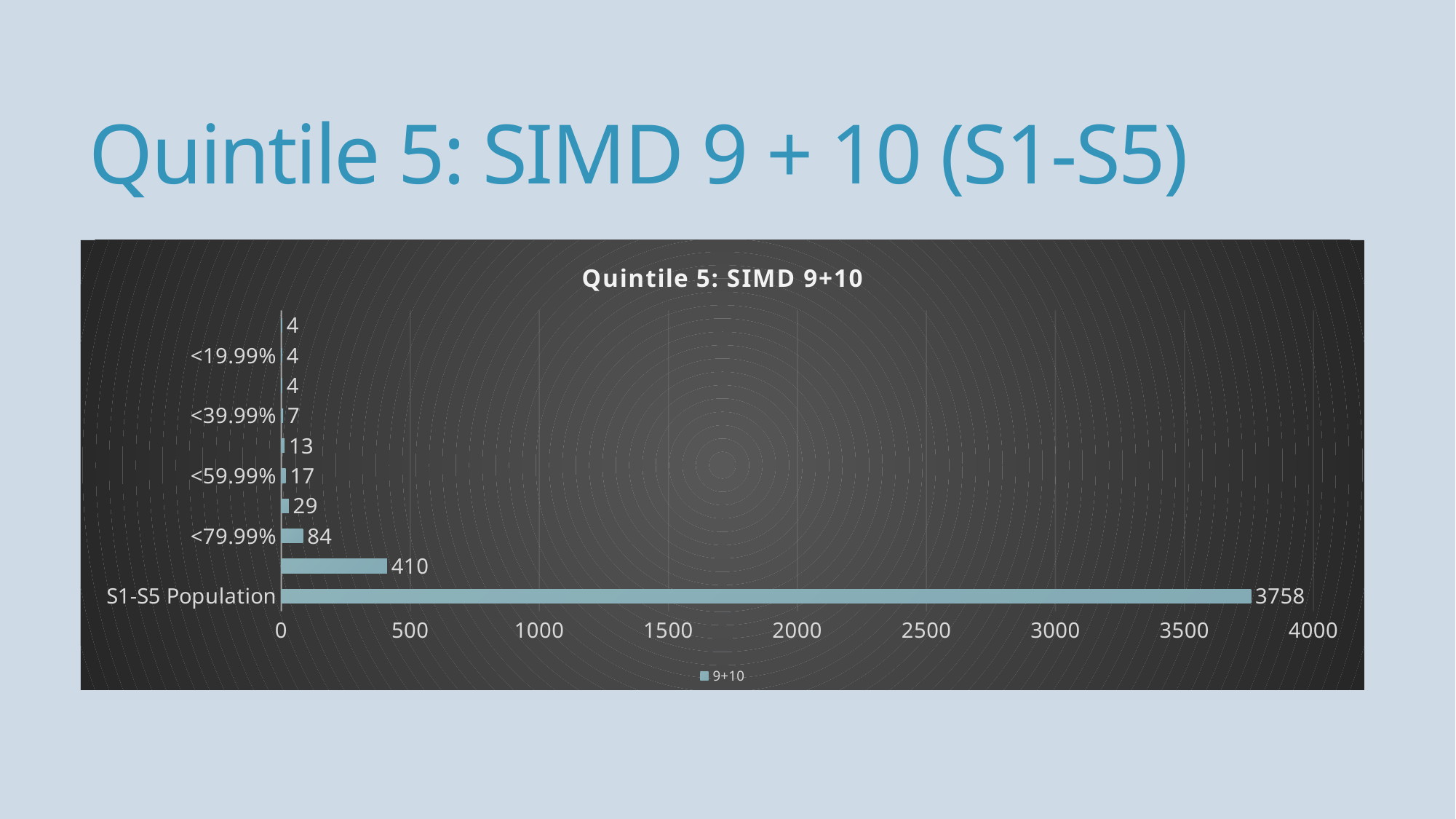
What is the value for the <59.99% category? 17 What is the value for S1-S5 Population? 3758 Which is larger, the value for <59.99% or the value for <39.99%? <59.99% What kind of chart is shown? Bar chart What is the value for the <19.99% category? 4 What is the difference between the S1-S5 Population value and the <79.99% value? 3674 How many bars are plotted in the chart? 10 What is the value for the <39.99% category? 7 Which labelled category has the highest value? S1-S5 Population What is the value for the <79.99% category? 84 What is the title of the chart? Quintile 5: SIMD 9+10 What is the difference between the <79.99% value and the <59.99% value? 67